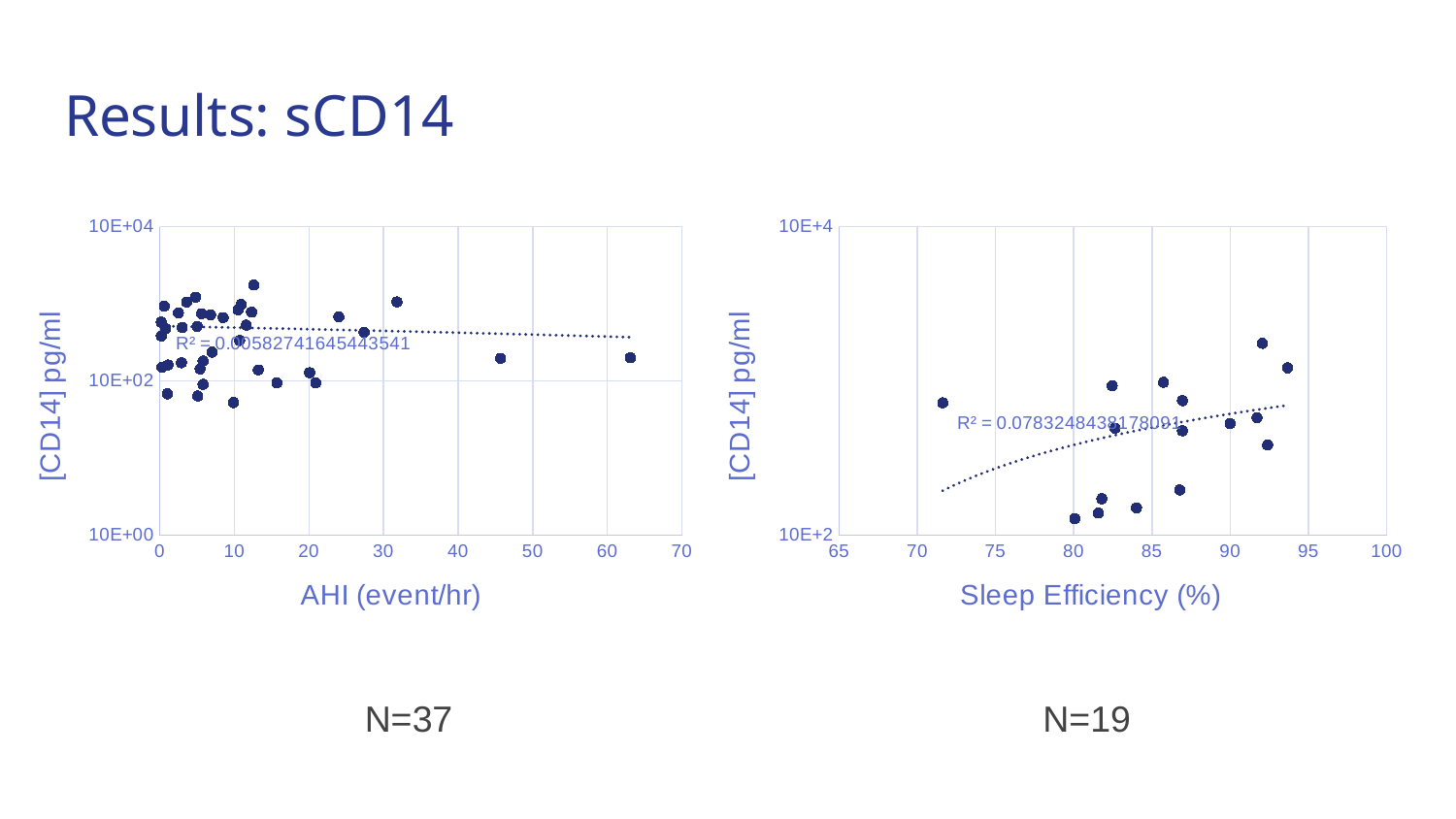
What kind of chart is the left chart on the slide? scatter plot In the right chart (Sleep Efficiency), what R² value is printed next to the trendline? R² = 0.0783248438178091 In the left chart (AHI), does the dotted trendline rise or fall as AHI increases? falls What is the x-axis label of the left chart? AHI (event/hr) In the right chart, is the [CD14] value of the leftmost point (at sleep efficiency just above 70) greater or less than 10E+2? greater In the left chart (AHI), what R² value is printed next to the trendline? R² = 0.00582741645443541 In the left chart, is the [CD14] value of the rightmost point (at AHI just above 60) greater or less than 10E+02? greater In the right chart (Sleep Efficiency), does the dotted trendline rise or fall as sleep efficiency increases? rises What kind of chart is the right chart on the slide? scatter plot In the left chart (AHI), how many data points are plotted, according to the N shown below it? 37 What is the x-axis label of the right chart? Sleep Efficiency (%) In the right chart (Sleep Efficiency), how many data points are plotted, according to the N shown below it? 19